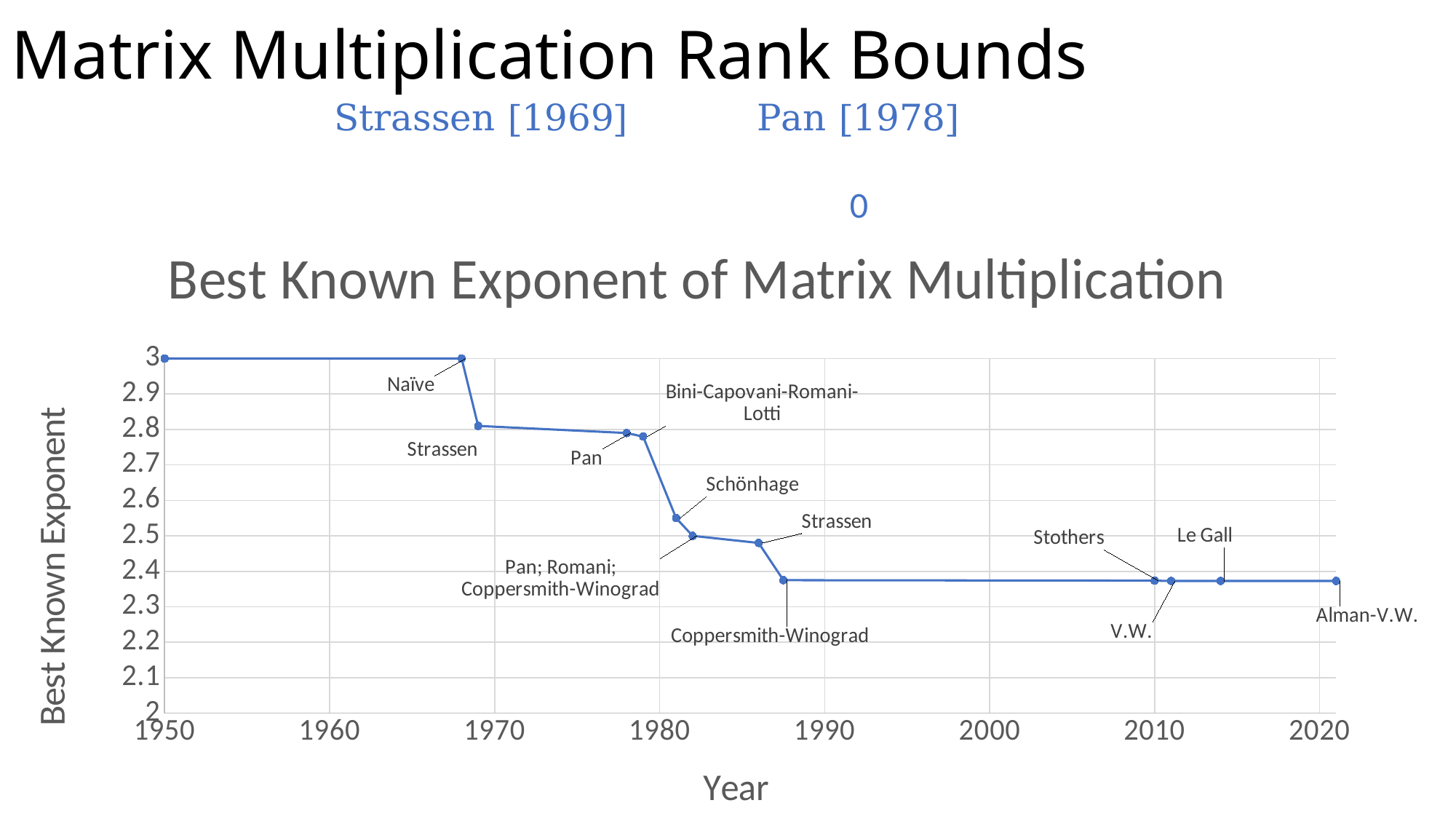
What is the best known exponent for the point labelled Naïve? 3 Does the best known exponent rise or fall as the year increases? fall Is the value for Bini-Capovani-Romani-Lotti greater or less than 2.7? greater Is the value for Schönhage greater or less than 2.6? less What is the label of the vertical axis of the chart? Best Known Exponent What is the title of the chart? Best Known Exponent of Matrix Multiplication What kind of chart is shown on the slide? line chart How many data points are plotted on the line? 13 Is the value for Coppersmith-Winograd greater or less than 2.4? less Which labelled point has the highest best known exponent? Naïve Which has the higher best known exponent, Schönhage or Coppersmith-Winograd? Schönhage